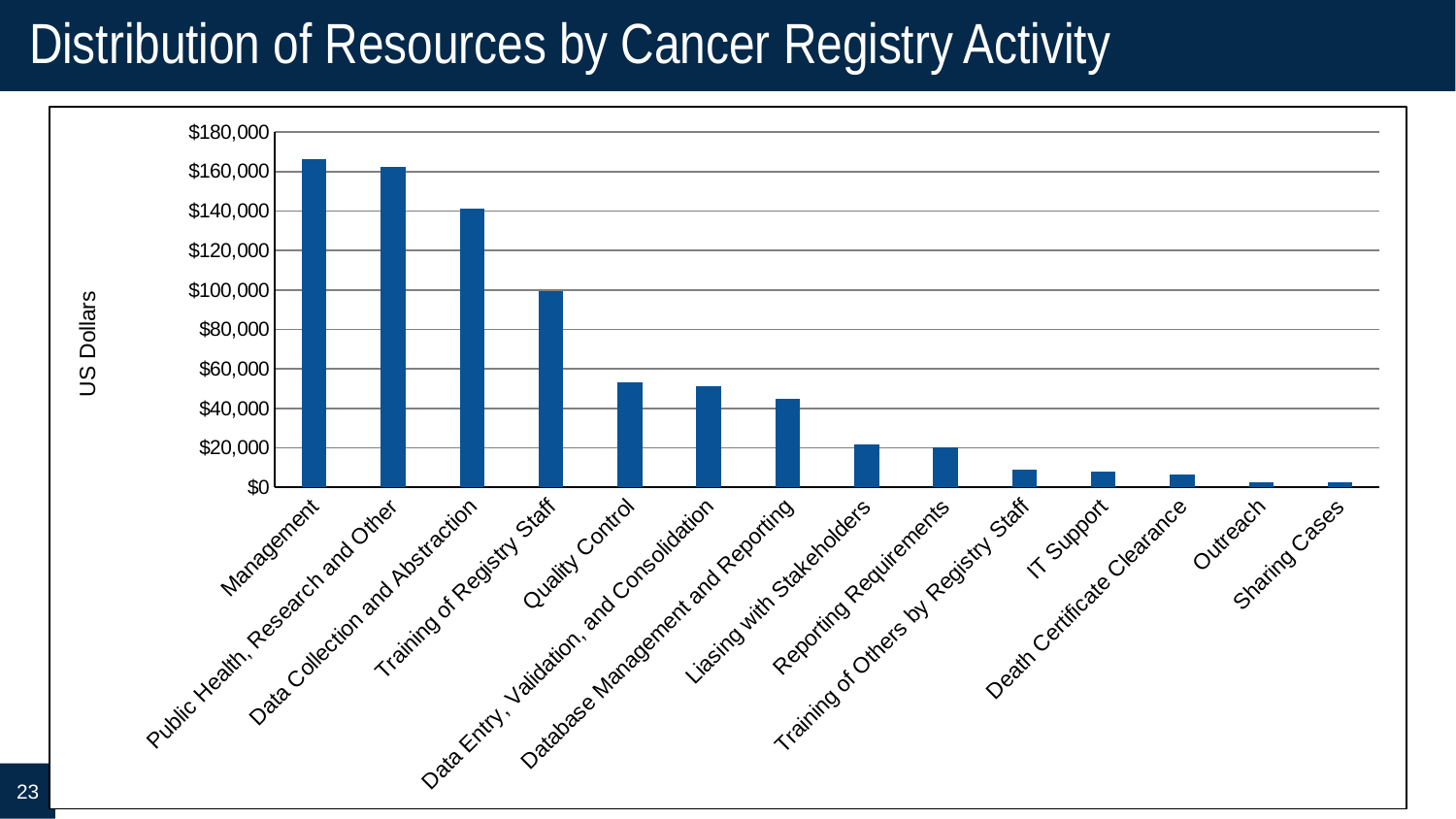
Is the value for Quality Control greater or less than $40,000? greater What kind of chart is shown on the slide? bar chart Is the value for IT Support greater or less than $20,000? less Is the value for Liasing with Stakeholders greater or less than $40,000? less Which has a larger value, Quality Control or Database Management and Reporting? Quality Control What is the title of the slide containing the chart? Distribution of Resources by Cancer Registry Activity What is the label of the y axis? US Dollars How many activity categories are plotted on the x axis? 14 Do the values generally rise or fall moving from left to right along the x axis? fall